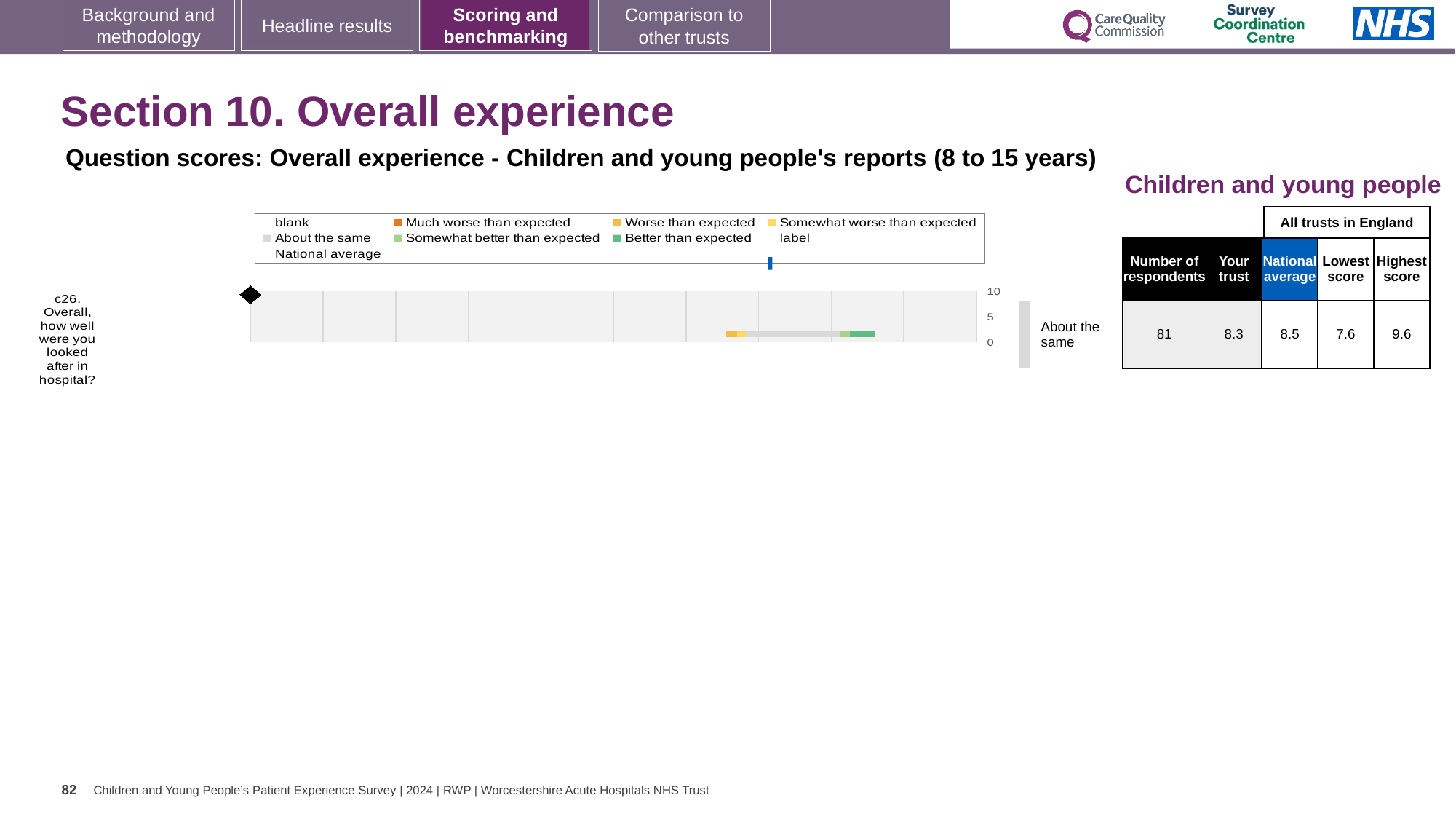
What is the difference between the highest score and the lowest score for question c26 in the table beside the chart? 2.0 How many survey questions are plotted in the chart? 1 What is the highest value shown on the chart's score axis? 10 What colour represents 'Better than expected' in the chart legend? green According to the table beside the chart, what is the score for 'Your trust' on question c26? 8.3 According to the table beside the chart, what is the lowest score among all trusts in England for question c26? 7.6 What benchmark category is shown next to the bar for question c26? About the same How many respondents answered question c26, according to the table beside the chart? 81 According to the table beside the chart, what is the national average score for question c26? 8.5 According to the table beside the chart, what is the highest score among all trusts in England for question c26? 9.6 Which is larger for question c26: the 'Your trust' score or the national average? National average What kind of chart is used to show the question score for c26? bar chart